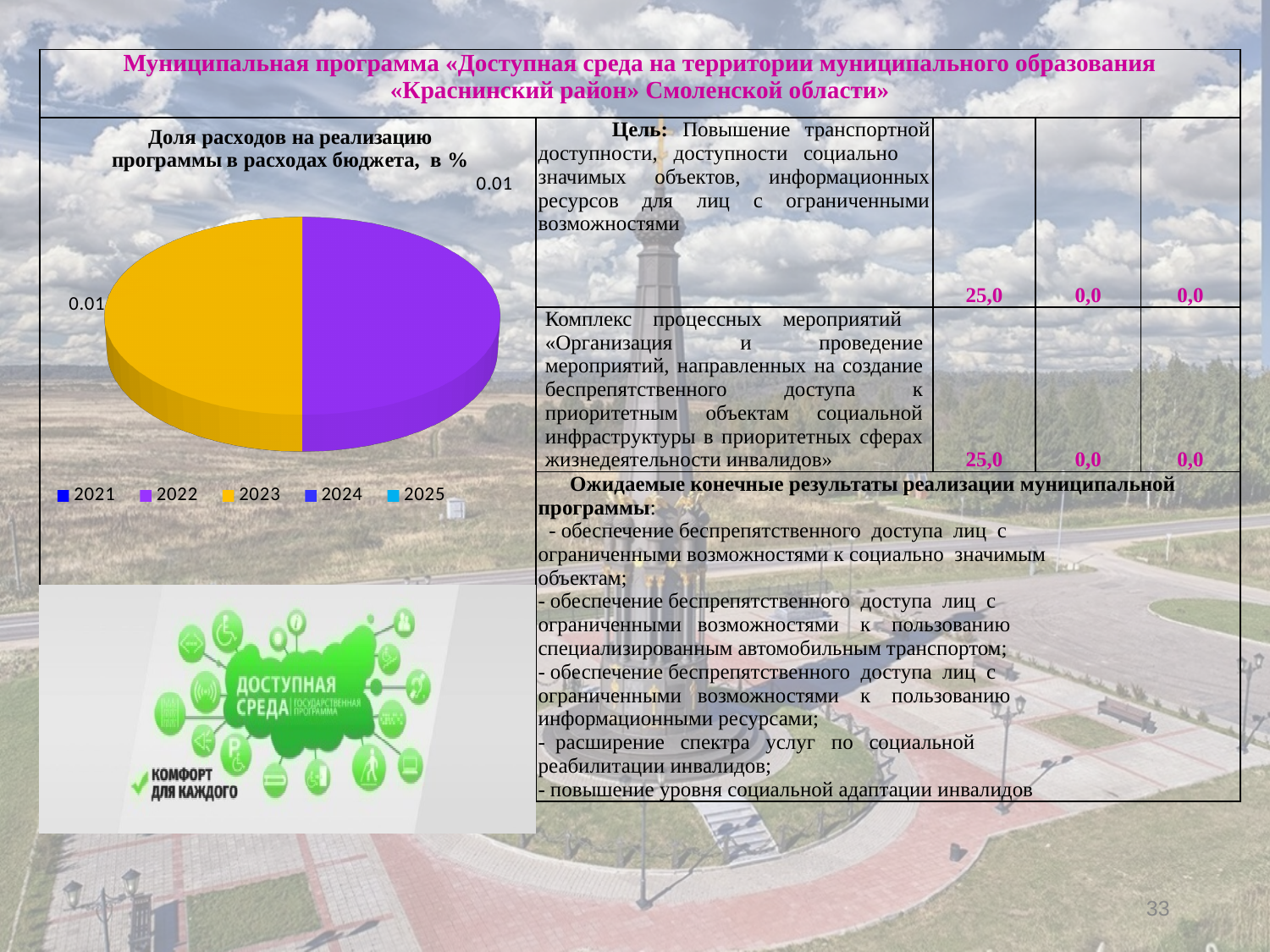
Which year does the yellow slice of the pie chart represent? 2023 Which years are listed in the legend of the pie chart? 2021, 2022, 2023, 2024, 2025 How many series does the legend of the pie chart list? 5 What is the value shown for 2022 in the pie chart? 0.01 What is the title of the pie chart? Доля расходов на реализацию программы в расходах бюджета, в % What is the value shown for 2023 in the pie chart? 0.01 What kind of chart is shown on the slide? pie chart How many slices are visible in the pie chart? 2 Is the value for 2022 in the pie chart greater or less than 1? less